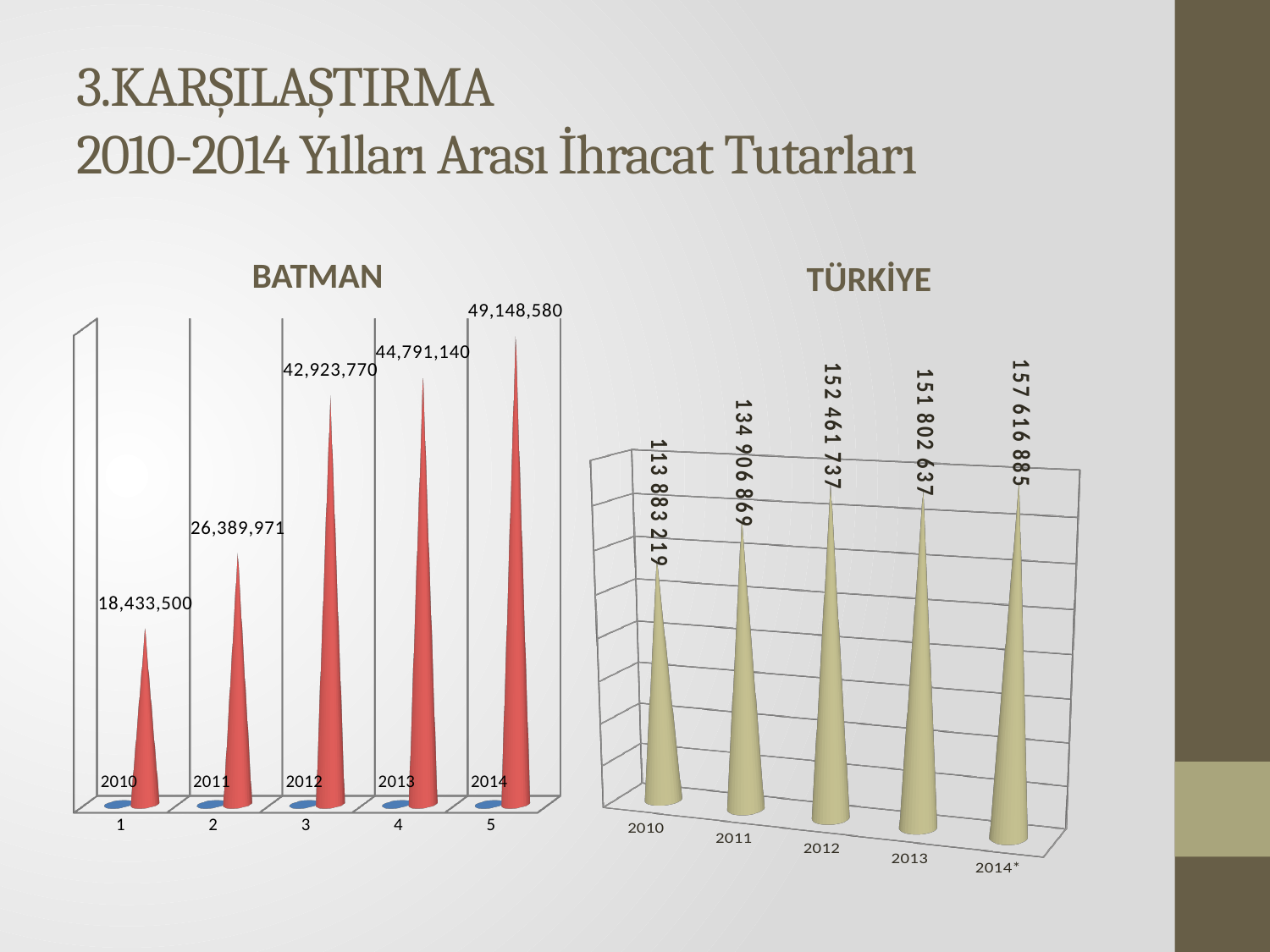
In the BATMAN chart, what is the difference between the 2011 and 2010 values? 7,956,471 In the BATMAN chart, which year has the lowest value? 2010 In the TÜRKİYE chart, what is the value for 2014*? 157 616 885 In the BATMAN chart, which year has the highest value? 2014 In the BATMAN chart, what is the value for 2013? 44,791,140 In the TÜRKİYE chart, which year has the lowest value? 2010 In the TÜRKİYE chart, which is larger, the value for 2012 or the value for 2013? 2012 What kind of chart is the BATMAN chart? bar chart In the TÜRKİYE chart, what is the value for 2011? 134 906 869 In the BATMAN chart, what is the value for 2010? 18,433,500 In the BATMAN chart, do the values rise or fall from 2010 to 2014? rise How many years are plotted in the TÜRKİYE chart? 5